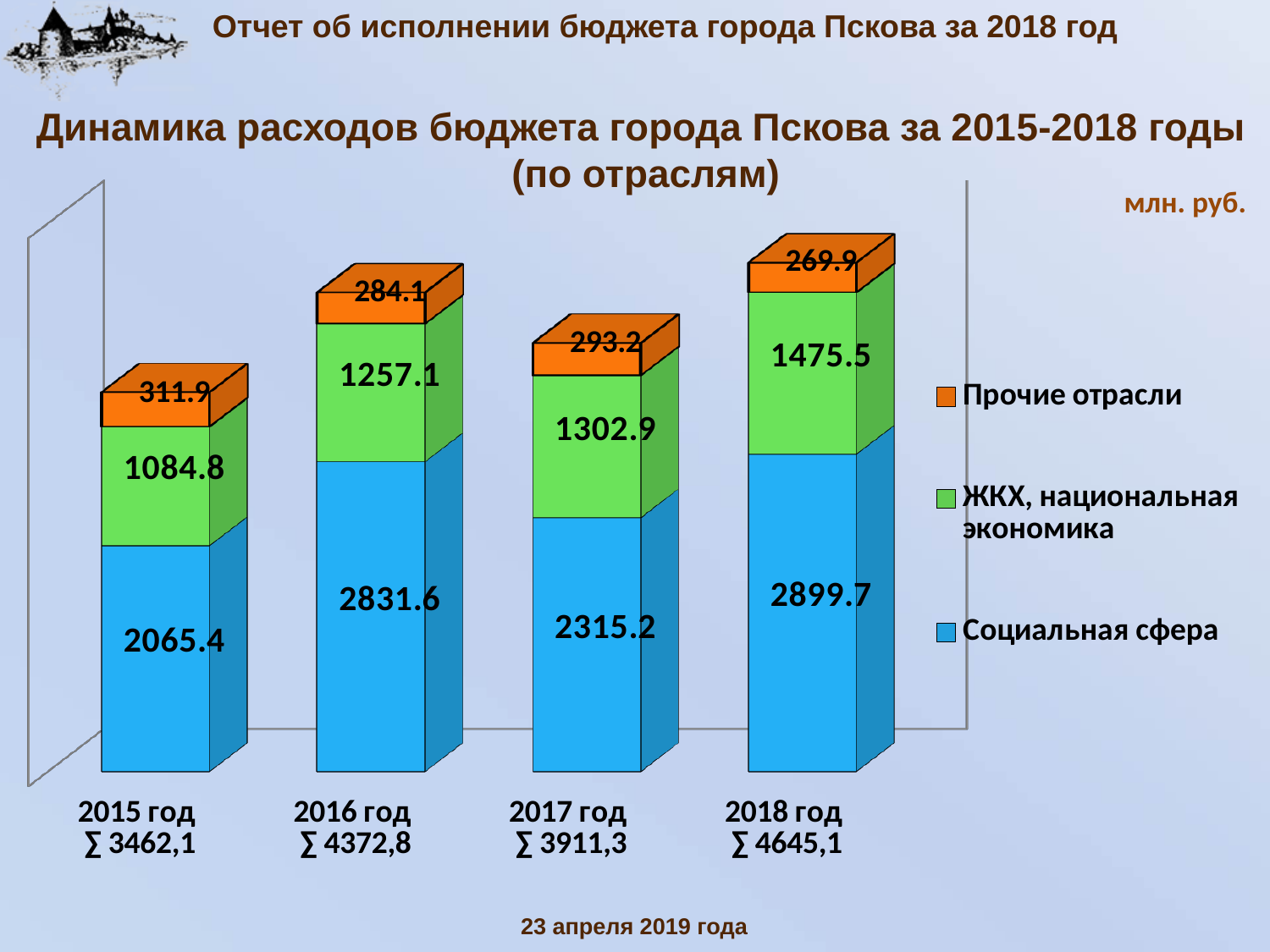
What is the value for Социальная сфера in 2017 год? 2315.2 Which is larger: ЖКХ, национальная экономика in 2017 год or in 2016 год? 2017 год What is the value for Прочие отрасли in 2015 год? 311.9 In which year is the value for Прочие отрасли the lowest? 2018 год What kind of chart is shown on the slide? Stacked bar chart How many years (categories) are shown on the chart? 4 What is the value for Социальная сфера in 2018 год? 2899.7 In which year is the value for Социальная сфера the highest? 2018 год What is the difference between the Социальная сфера values for 2016 год and 2015 год? 766.2 How many series does the legend list? 3 What is the value for ЖКХ, национальная экономика in 2016 год? 1257.1 What is the total of the stacked bar for 2018 год as printed on the slide? 4645,1